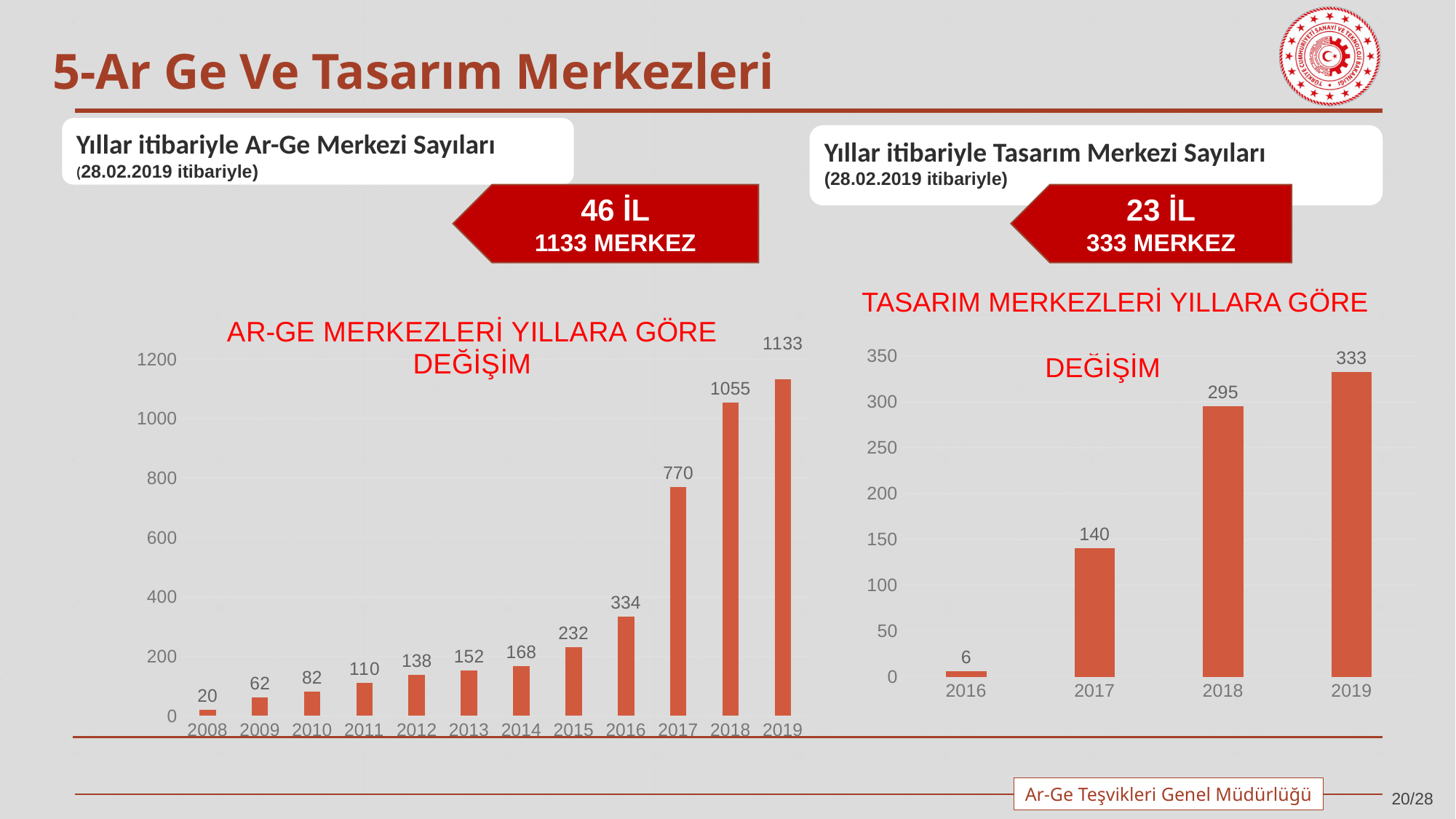
In the left chart (AR-GE MERKEZLERİ YILLARA GÖRE DEĞİŞİM), what is the difference between the values for 2019 and 2018? 78 In the right chart (TASARIM MERKEZLERİ YILLARA GÖRE DEĞİŞİM), which year has the lowest value? 2016 In the right chart (TASARIM MERKEZLERİ YILLARA GÖRE DEĞİŞİM), what is the difference between the values for 2018 and 2017? 155 In the right chart (TASARIM MERKEZLERİ YILLARA GÖRE DEĞİŞİM), what is the value for 2017? 140 Which is larger: the value for 2016 in the left chart (AR-GE MERKEZLERİ) or the value for 2019 in the right chart (TASARIM MERKEZLERİ)? 2016 in the left chart (334) In the left chart (AR-GE MERKEZLERİ YILLARA GÖRE DEĞİŞİM), how many years are shown on the x axis? 12 In the left chart (AR-GE MERKEZLERİ YILLARA GÖRE DEĞİŞİM), what is the value for 2008? 20 In the left chart (AR-GE MERKEZLERİ YILLARA GÖRE DEĞİŞİM), what is the value for 2017? 770 In the left chart (AR-GE MERKEZLERİ YILLARA GÖRE DEĞİŞİM), which year has the highest value? 2019 In the left chart (AR-GE MERKEZLERİ YILLARA GÖRE DEĞİŞİM), do the values rise or fall from 2008 to 2019? rise What kind of chart is the right chart (TASARIM MERKEZLERİ YILLARA GÖRE DEĞİŞİM)? bar chart In the right chart (TASARIM MERKEZLERİ YILLARA GÖRE DEĞİŞİM), how many years are shown? 4